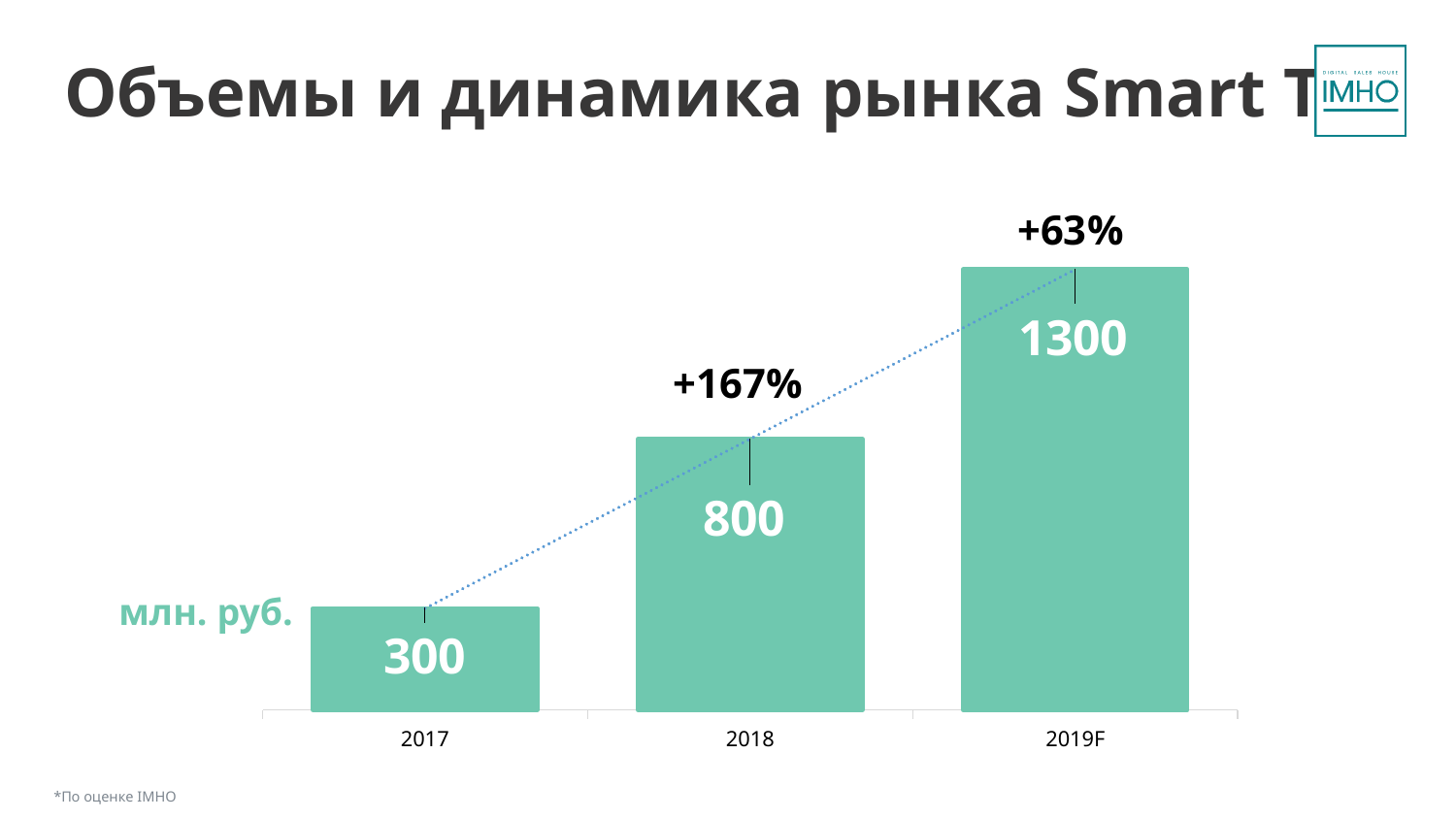
What is the value for 2017? 300 What is the difference between the values for 2018 and 2017? 500 How many categories are shown on the x axis? 3 What is the value for 2019F? 1300 Which year has the lowest value? 2017 What is the difference between the values for 2019F and 2018? 500 What kind of chart is this? bar chart What is the value for 2018? 800 Do the values rise or fall from 2017 to 2019F? rise Which year has the highest value? 2019F What growth percentage is shown above the 2018 bar? +167% Which is larger, the value for 2018 or the value for 2017? 2018